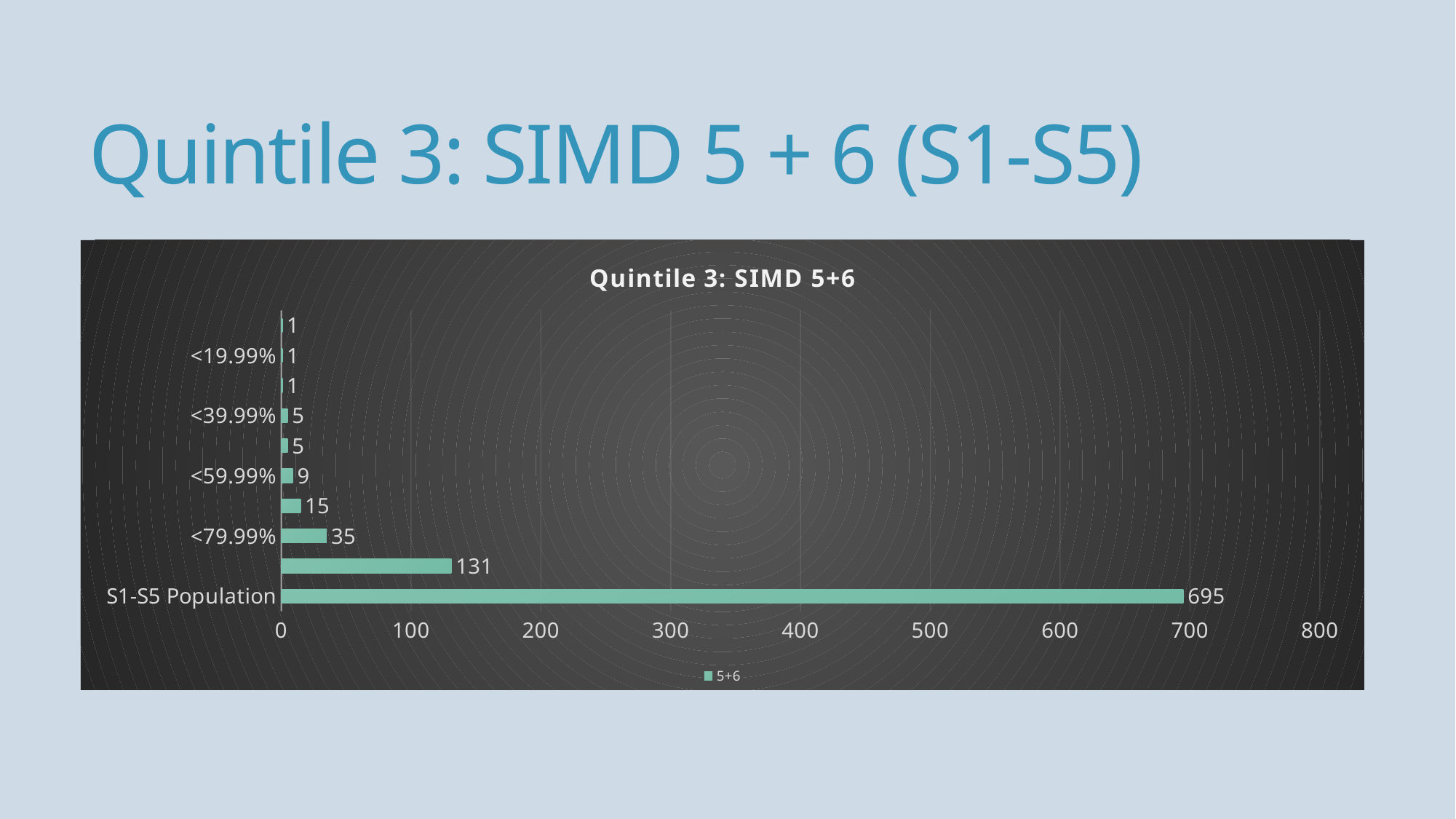
What kind of chart is shown on the slide? bar chart What is the value for the <19.99% category? 1 What is the value for S1-S5 Population? 695 What is the value for the <79.99% category? 35 What is the value for the <39.99% category? 5 Is the value for S1-S5 Population greater or less than 600? greater What is the difference between the value for S1-S5 Population and the value for <79.99%? 660 How many bars are plotted in the chart? 10 Which category has the highest value? S1-S5 Population Which is larger, the value for <59.99% or the value for <39.99%? <59.99% What is the value for the <59.99% category? 9 What is the difference between the value for <79.99% and the value for <59.99%? 26